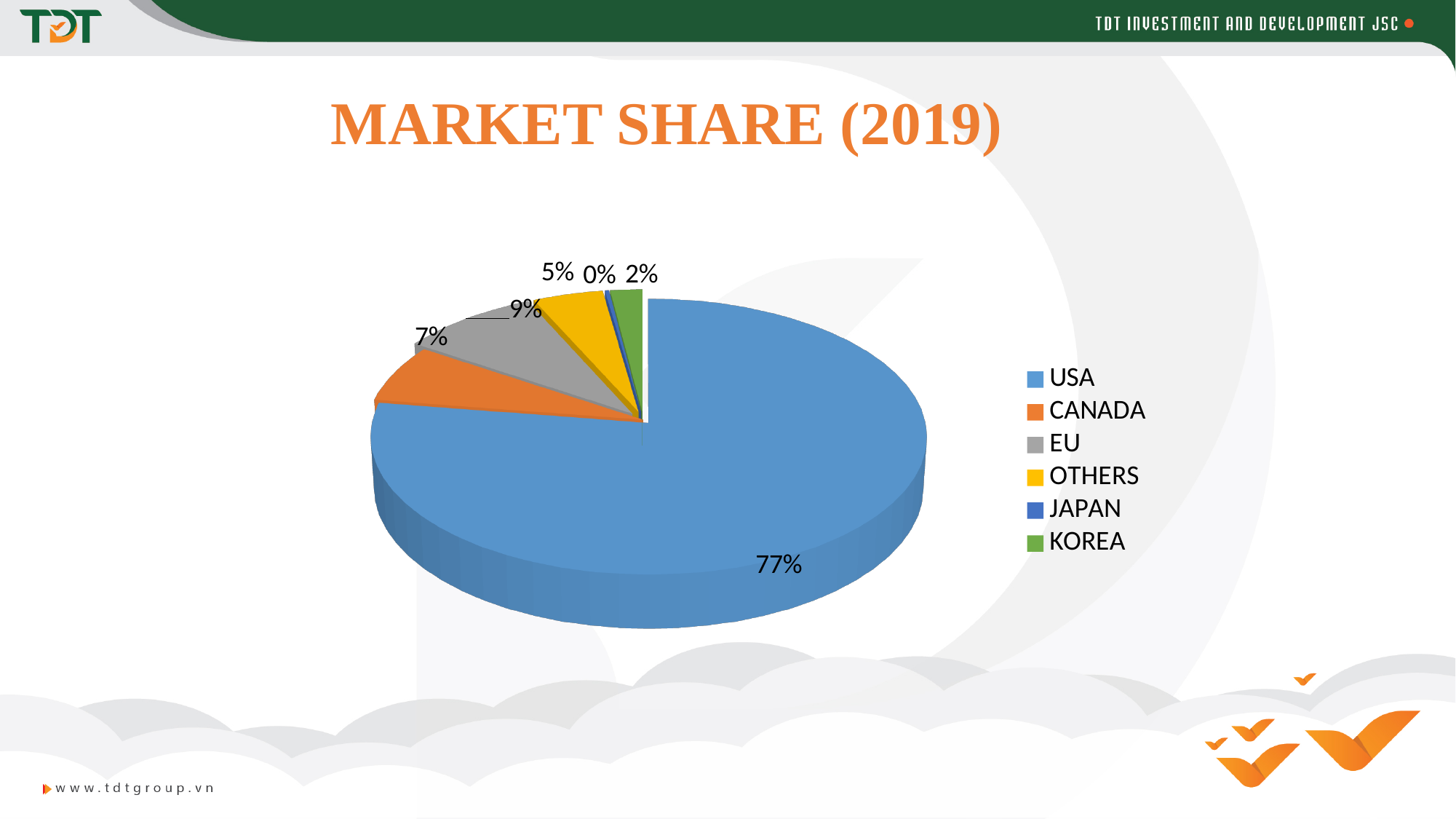
Which category has the smallest market share? JAPAN What is the market share of the USA? 77% Which category has the largest market share? USA How many categories does the legend list? 6 What is the market share of the EU? 9% What is the market share of Canada? 7% Which has a larger market share, the EU or Canada? EU What is the market share of Korea? 2% What is the difference in market share between the USA and the EU? 68% What kind of chart is shown on the slide? pie chart What is the market share of Japan? 0% What is the title of the chart? MARKET SHARE (2019)